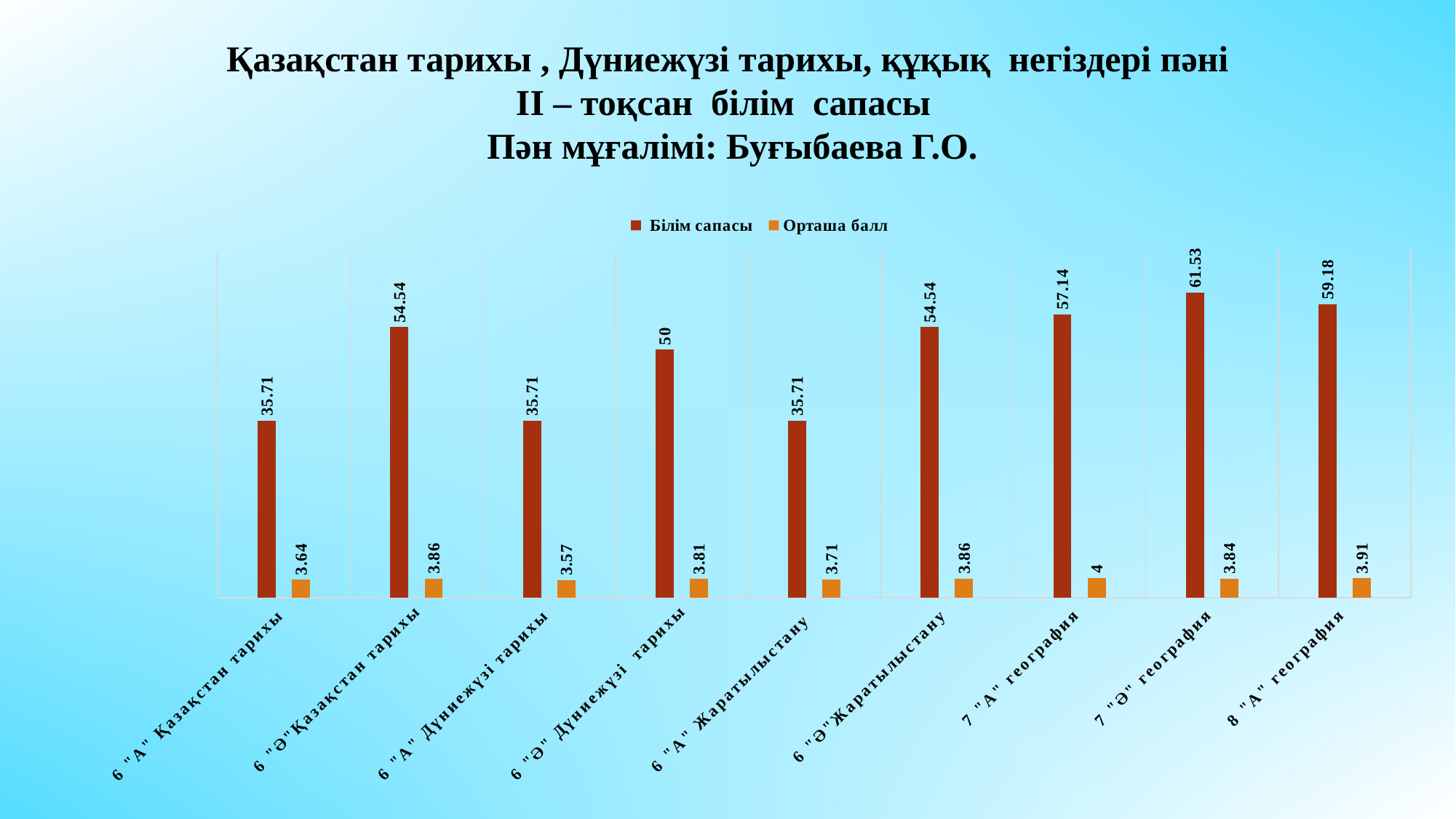
What are the two series names listed in the legend? Білім сапасы and Орташа балл How many series does the legend list? 2 Which category has the highest Білім сапасы value? 7 "Ә" география What type of chart is shown on the slide? bar chart Which category has the lowest Орташа балл value? 6 "А" Дүниежүзі тарихы What is the Білім сапасы value for 7 "Ә" география? 61.53 Which has a larger Білім сапасы value, 6 "Ә" Қазақстан тарихы or 7 "А" география? 7 "А" география Which category has the highest Орташа балл value? 7 "А" география How many categories are shown on the x axis? 9 What is the Орташа балл value for 6 "А" Қазақстан тарихы? 3.64 What is the difference between the Білім сапасы values for 7 "Ә" география and 8 "А" география? 2.35 What is the Білім сапасы value for 6 "Ә" Дүниежүзі тарихы? 50